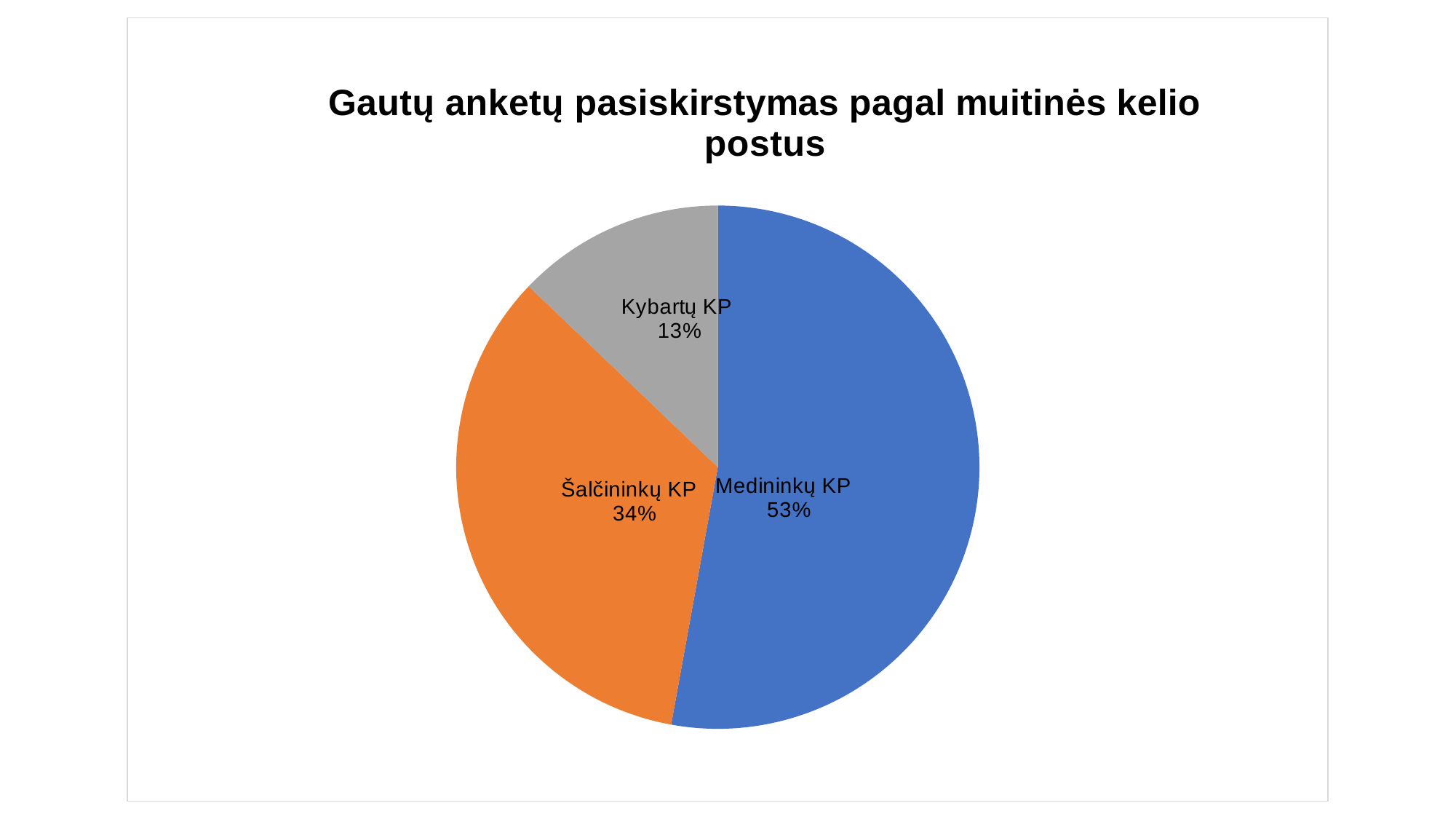
What share of the pie does Medininkų KP have? 53% What is the title of the chart? Gautų anketų pasiskirstymas pagal muitinės kelio postus What is the difference in percentage points between Šalčininkų KP and Kybartų KP? 21 Which customs post has the largest share of received questionnaires? Medininkų KP What share of the pie does Šalčininkų KP have? 34% How many customs posts are shown in the pie chart? 3 Which has a larger share, Šalčininkų KP or Kybartų KP? Šalčininkų KP What is the difference in percentage points between Medininkų KP and Šalčininkų KP? 19 Which customs post has the smallest share of received questionnaires? Kybartų KP What share of the pie does Kybartų KP have? 13% What colour is the slice for Šalčininkų KP? Orange What kind of chart is shown on the slide? Pie chart